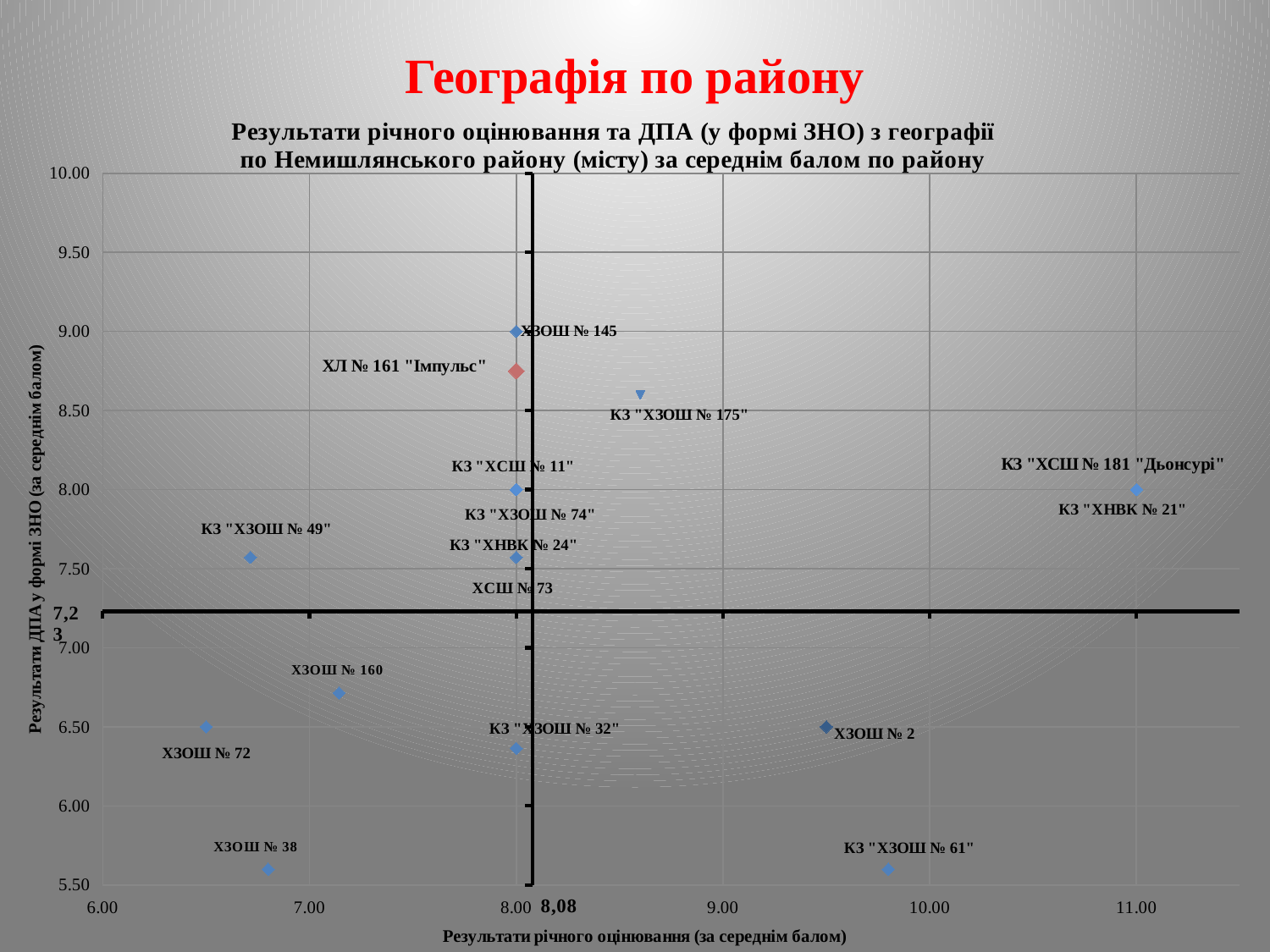
What is the ДПА (y-axis) value for КЗ "ХСШ № 11"? 8.00 Which school has the higher ДПА (y-axis) result, ХЗОШ № 160 or КЗ "ХЗОШ № 49"? КЗ "ХЗОШ № 49" What is the ДПА (y-axis) value for ХЗОШ № 145? 9.00 Which school has the highest annual assessment (x-axis) result? КЗ "ХСШ № 181 "Дьонсурі"" Is the ДПА (y-axis) value for ХЗОШ № 38 greater or less than 6.00? less What is the annual assessment (x-axis) value for КЗ "ХСШ № 181 "Дьонсурі""? 11.00 Which school has the highest ДПА (y-axis) result? ХЗОШ № 145 What value is marked on the x-axis by the vertical reference line? 8,08 Is the ДПА (y-axis) value for КЗ "ХЗОШ № 175" greater or less than 8.50? greater Is the annual assessment (x-axis) value for ХЗОШ № 2 greater or less than 9.00? greater Which school has the lowest annual assessment (x-axis) result? ХЗОШ № 72 What kind of chart is shown on the slide? scatter chart